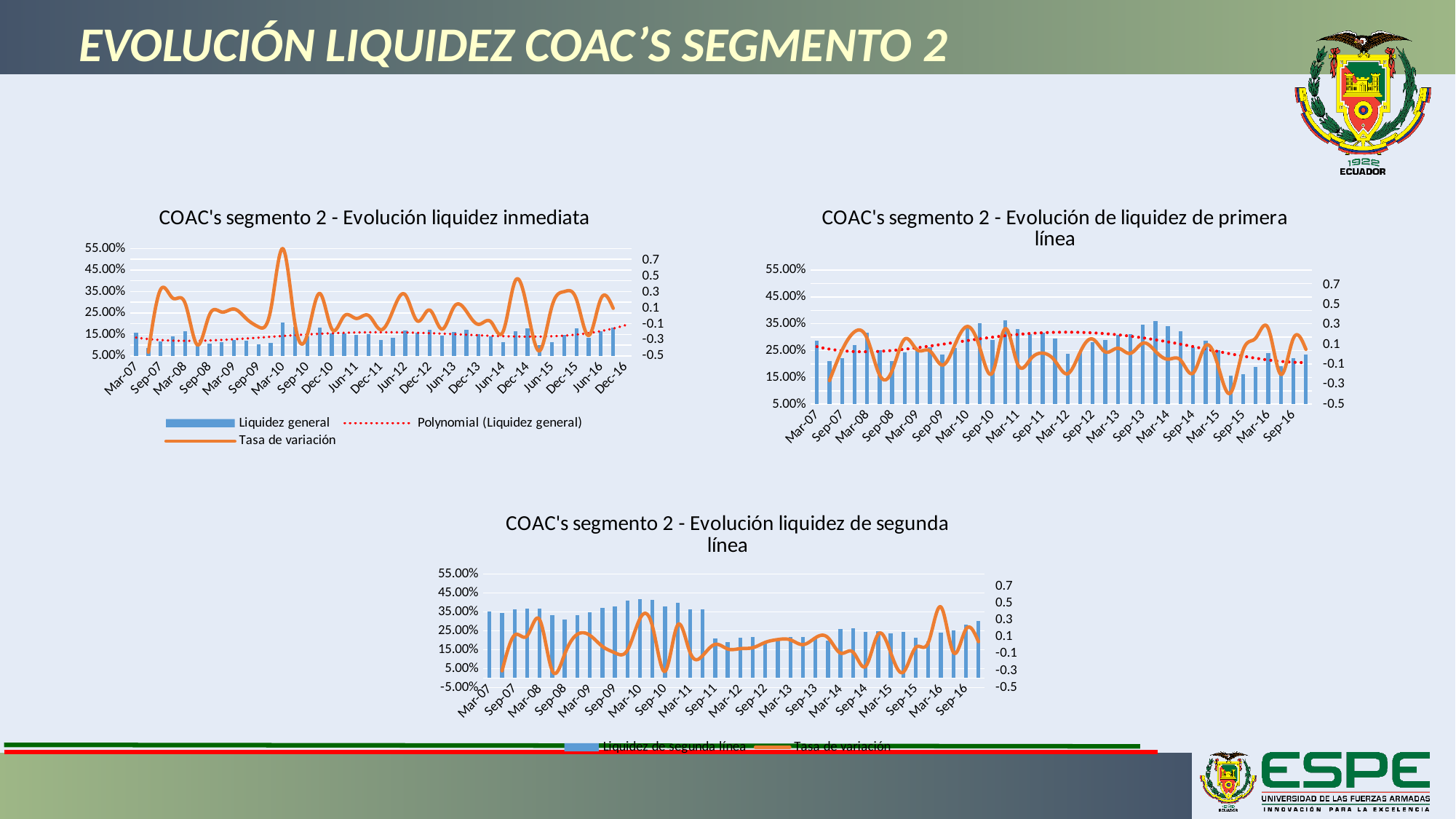
In the chart 'COAC's segmento 2 - Evolución liquidez inmediata', is the Tasa de variación value at Mar-10 greater or less than 0.5? greater What kind of chart is 'COAC's segmento 2 - Evolución liquidez inmediata'? bar and line chart In the chart 'COAC's segmento 2 - Evolución liquidez de segunda línea', is the Liquidez de segunda línea bar for Sep-14 greater or less than 35.00%? less In the chart 'COAC's segmento 2 - Evolución liquidez inmediata', is the Liquidez general bar for Mar-10 greater or less than 25.00%? less In the chart 'COAC's segmento 2 - Evolución liquidez de segunda línea', how many series does the legend list? 2 In the chart 'COAC's segmento 2 - Evolución liquidez inmediata', at which period does the Tasa de variación line reach its highest point? Mar-10 In the chart 'COAC's segmento 2 - Evolución liquidez inmediata', how many series does the legend list? 3 In the chart 'COAC's segmento 2 - Evolución liquidez de segunda línea', do the Liquidez de segunda línea bars generally rise or fall from Mar-07 to Sep-16? fall What is the title of the chart in the top-left of the slide? COAC's segmento 2 - Evolución liquidez inmediata In the chart 'COAC's segmento 2 - Evolución liquidez inmediata', what colour is the Tasa de variación line? orange